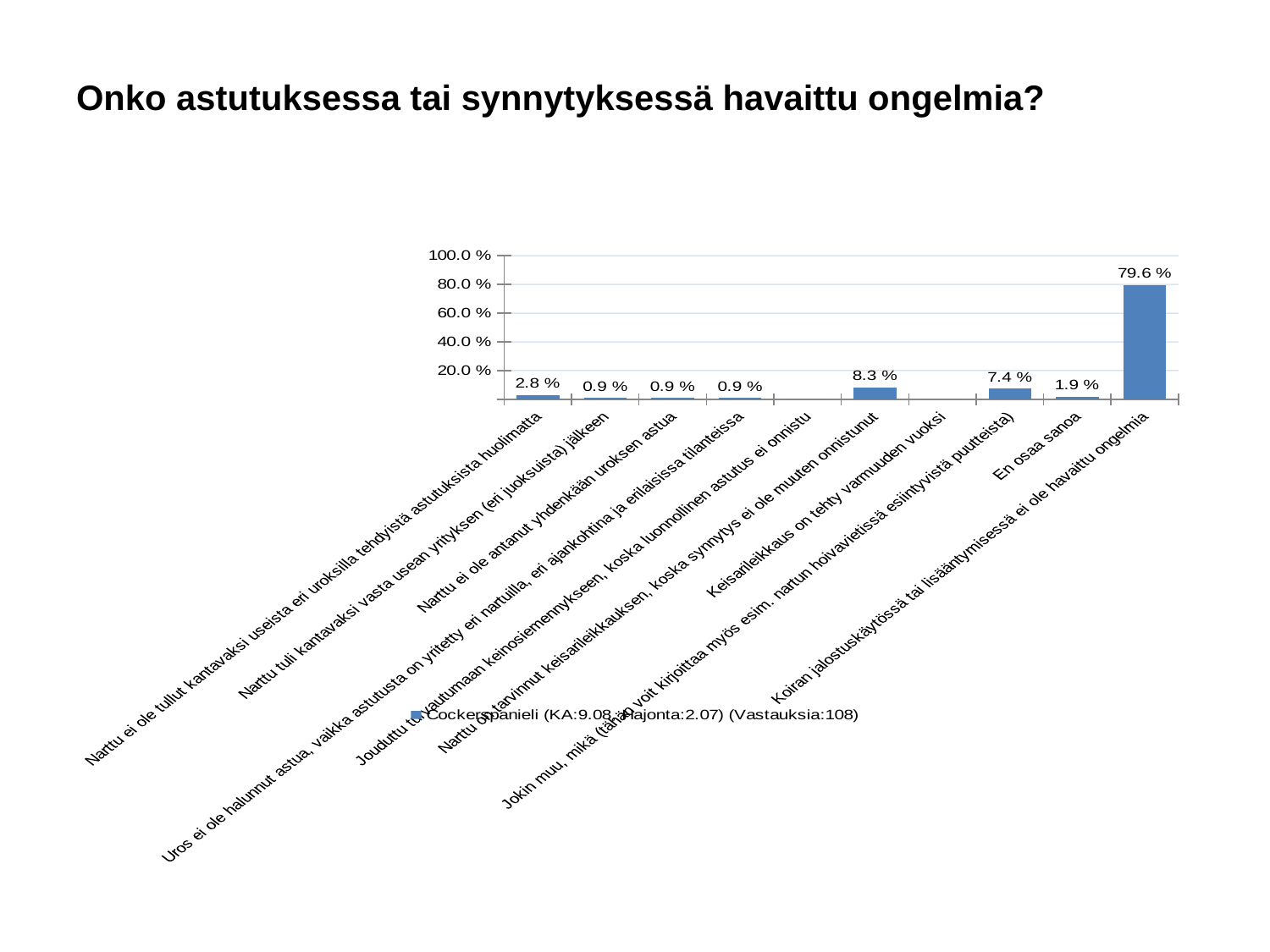
What is the value for "Narttu ei ole tullut kantavaksi useista eri uroksilla tehdyistä astutuksista huolimatta"? 2.8 % Is the value for "Koiran jalostuskäytössä tai lisääntymisessä ei ole havaittu ongelmia" greater or less than 60.0 %? greater Which is larger: the value for "En osaa sanoa" or the value for "Narttu ei ole tullut kantavaksi useista eri uroksilla tehdyistä astutuksista huolimatta"? Narttu ei ole tullut kantavaksi useista eri uroksilla tehdyistä astutuksista huolimatta How many categories are shown on the x axis? 10 What kind of chart is shown on the slide? bar chart What is the value for "Narttu on tarvinnut keisarileikkauksen, koska synnytys ei ole muuten onnistunut"? 8.3 % What is the value for "Koiran jalostuskäytössä tai lisääntymisessä ei ole havaittu ongelmia"? 79.6 % What is the title of the slide? Onko astutuksessa tai synnytyksessä havaittu ongelmia? Which category has the highest value? Koiran jalostuskäytössä tai lisääntymisessä ei ole havaittu ongelmia What is the difference between the value for "Narttu on tarvinnut keisarileikkauksen, koska synnytys ei ole muuten onnistunut" and the value for "Jokin muu, mikä"? 0.9 % What is the value for "En osaa sanoa"? 1.9 %